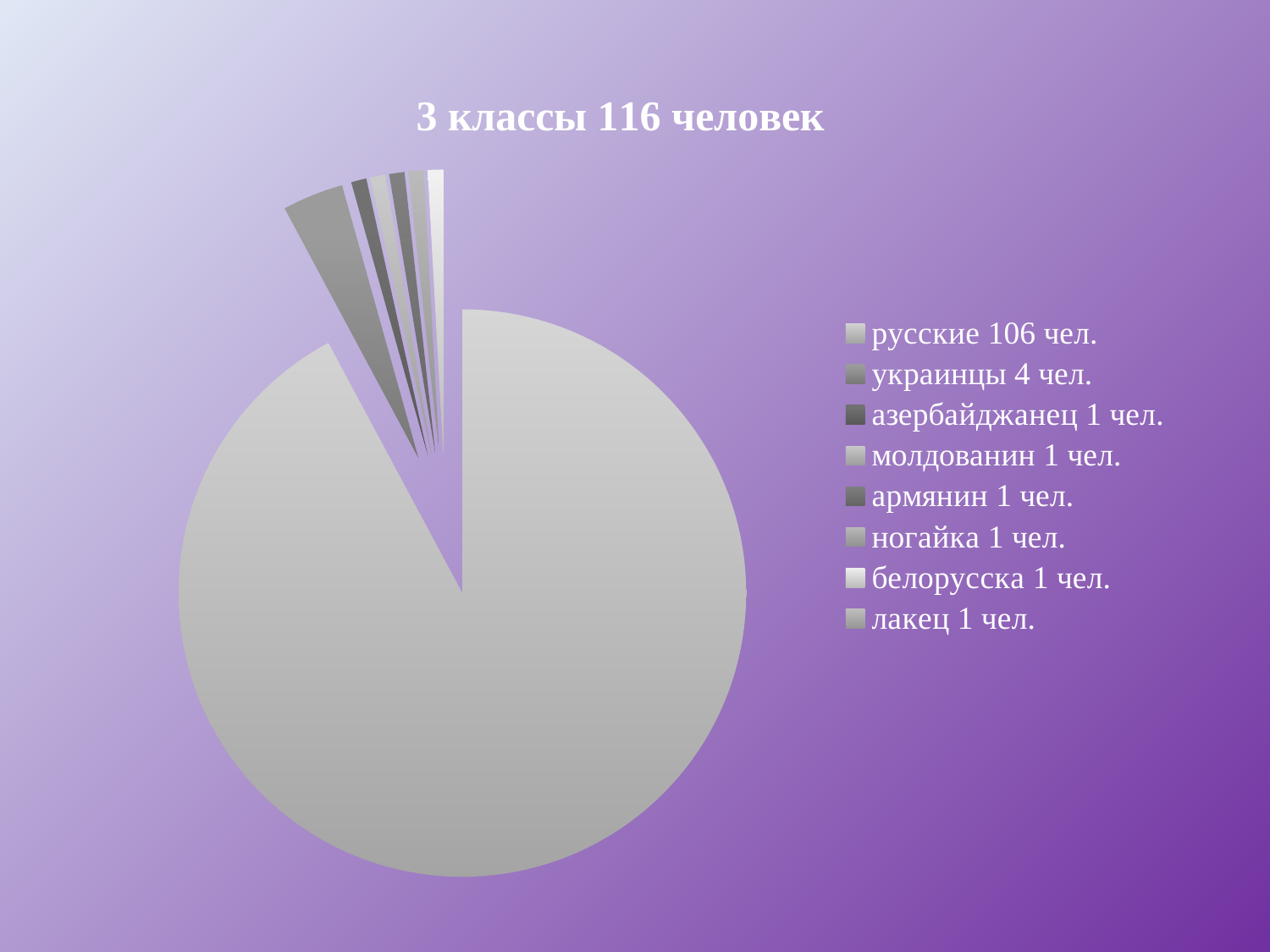
How many people are in the русские category? 106 чел. Which legend entry is listed last? лакец 1 чел. What is the difference between the number of русские and the number of украинцы? 102 How many people are in the украинцы category? 4 чел. What is the title of the chart? 3 классы 116 человек How many categories does the legend of the pie chart list? 8 Which is larger, the украинцы slice or the армянин slice? украинцы How many categories in the legend have exactly 1 чел.? 6 What is the total number of people represented in the pie chart? 116 How many people are in the азербайджанец category? 1 чел. What kind of chart is shown on the slide? pie chart Which category has the largest slice of the pie? русские